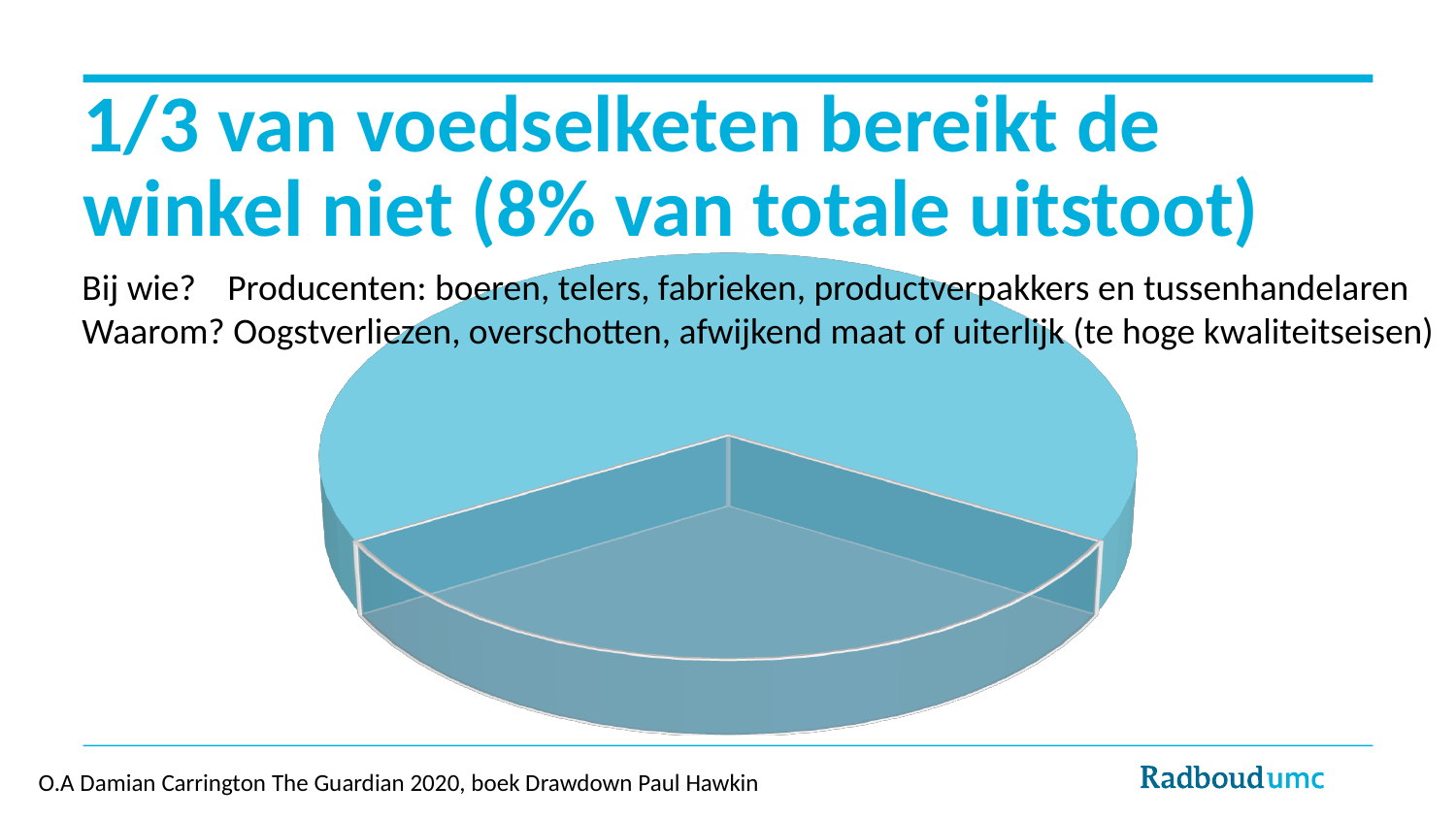
Does the pie chart have a legend? No Is the pie chart drawn in 3D or flat? 3D Is the smaller slice of the pie chart larger or smaller than half of the pie? smaller What kind of chart is shown on the slide? pie chart Which slice of the pie chart is larger: the light blue slice at the top or the darker slice at the bottom front? the light blue slice at the top